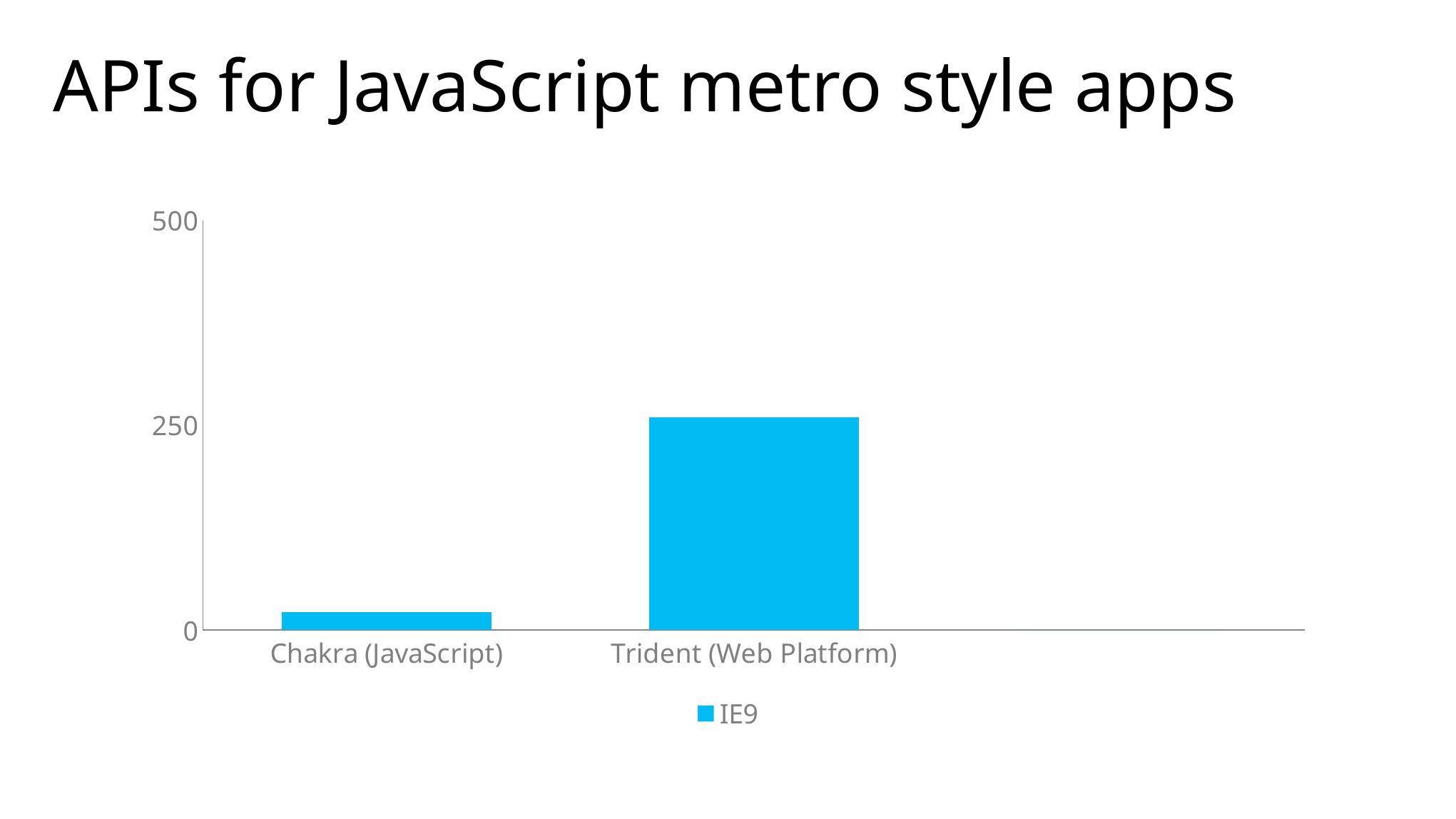
What is the title of the slide containing the chart? APIs for JavaScript metro style apps What kind of chart is shown on the slide? bar chart Which category has the highest value? Trident (Web Platform) How many categories are shown on the x axis? 2 Do the values rise or fall from Chakra (JavaScript) to Trident (Web Platform)? rise Is the value for Chakra (JavaScript) greater or less than 250? less What is the name of the series shown in the legend? IE9 Which category has the lowest value? Chakra (JavaScript) Is the value for Trident (Web Platform) greater or less than 500? less How many series does the legend list? 1 Which is larger, the value for Chakra (JavaScript) or the value for Trident (Web Platform)? Trident (Web Platform)